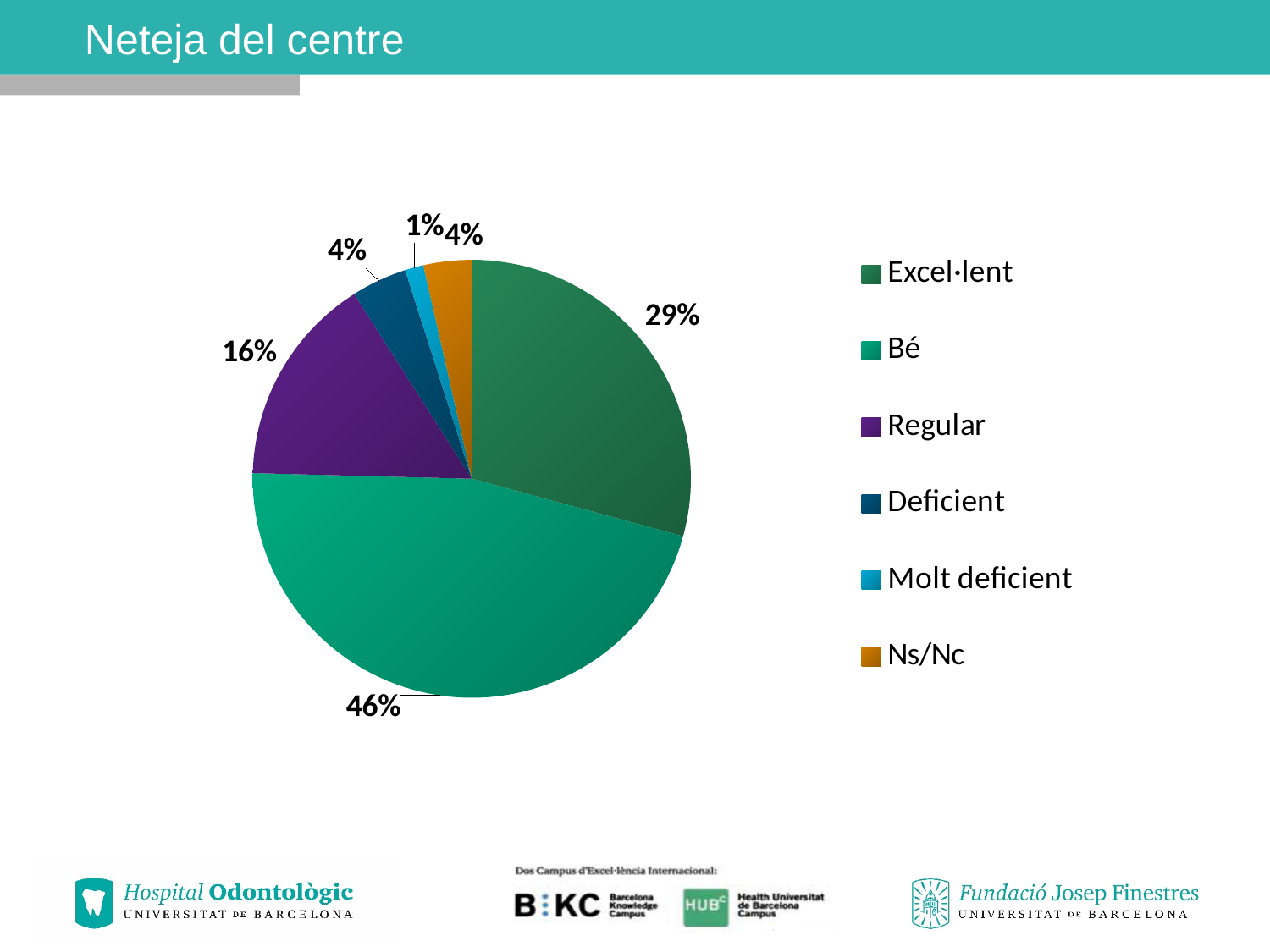
What share of the pie does Bé represent? 46% What percentage is shown for Excel·lent? 29% How many categories does the legend list? 6 Which category has the smallest slice of the pie? Molt deficient What is the combined share of Excel·lent and Bé? 75% What is the title of the slide containing the chart? Neteja del centre Which is larger, the share for Regular or the share for Excel·lent? Excel·lent What is the difference in percentage points between Bé and Excel·lent? 17 What type of chart is shown on the slide? Pie chart What percentage is shown for Molt deficient? 1% Which category has the largest slice of the pie? Bé What is the value for Regular? 16%